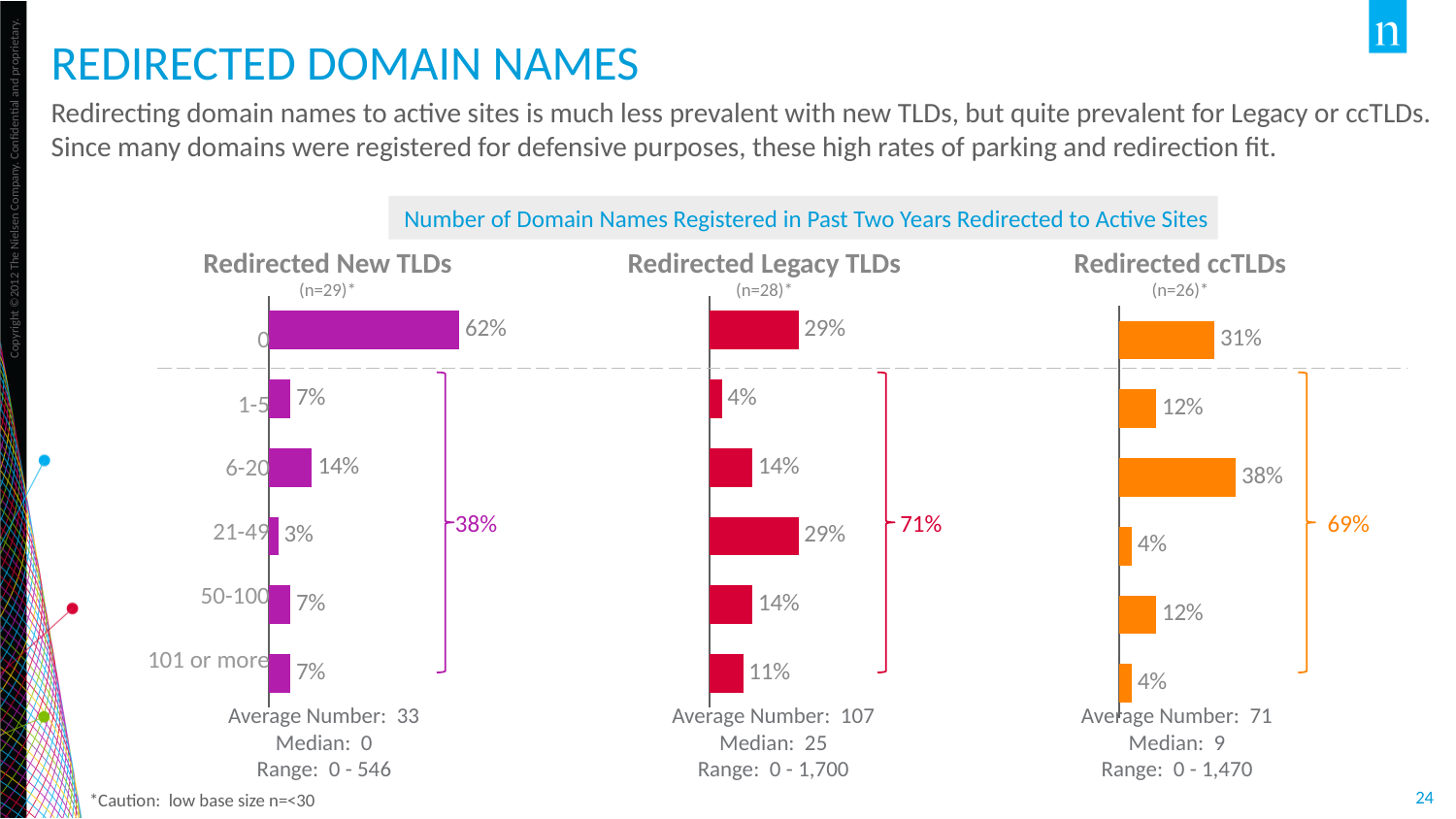
In the Redirected Legacy TLDs chart, what percentage is shown for the 21-49 category? 29% In the Redirected New TLDs chart, what percentage is shown for the 0 category? 62% How many categories are plotted in the Redirected Legacy TLDs chart? 6 What bracketed percentage is shown beside the Redirected ccTLDs chart for the categories 1-5 through 101 or more? 69% In the Redirected ccTLDs chart, what is the difference between the 0 category and the 101 or more category? 27% In the Redirected New TLDs chart, is the value for 6-20 larger or smaller than the value for 1-5? larger What type of chart is used for Redirected ccTLDs? bar chart What is the Average Number shown below the Redirected Legacy TLDs chart? 107 In the Redirected Legacy TLDs chart, what is the difference between the 0 category and the 1-5 category? 25% In the Redirected New TLDs chart, which category has the lowest percentage? 21-49 In the Redirected ccTLDs chart, which category has the highest percentage? 6-20 In the Redirected ccTLDs chart, what percentage is shown for the 6-20 category? 38%